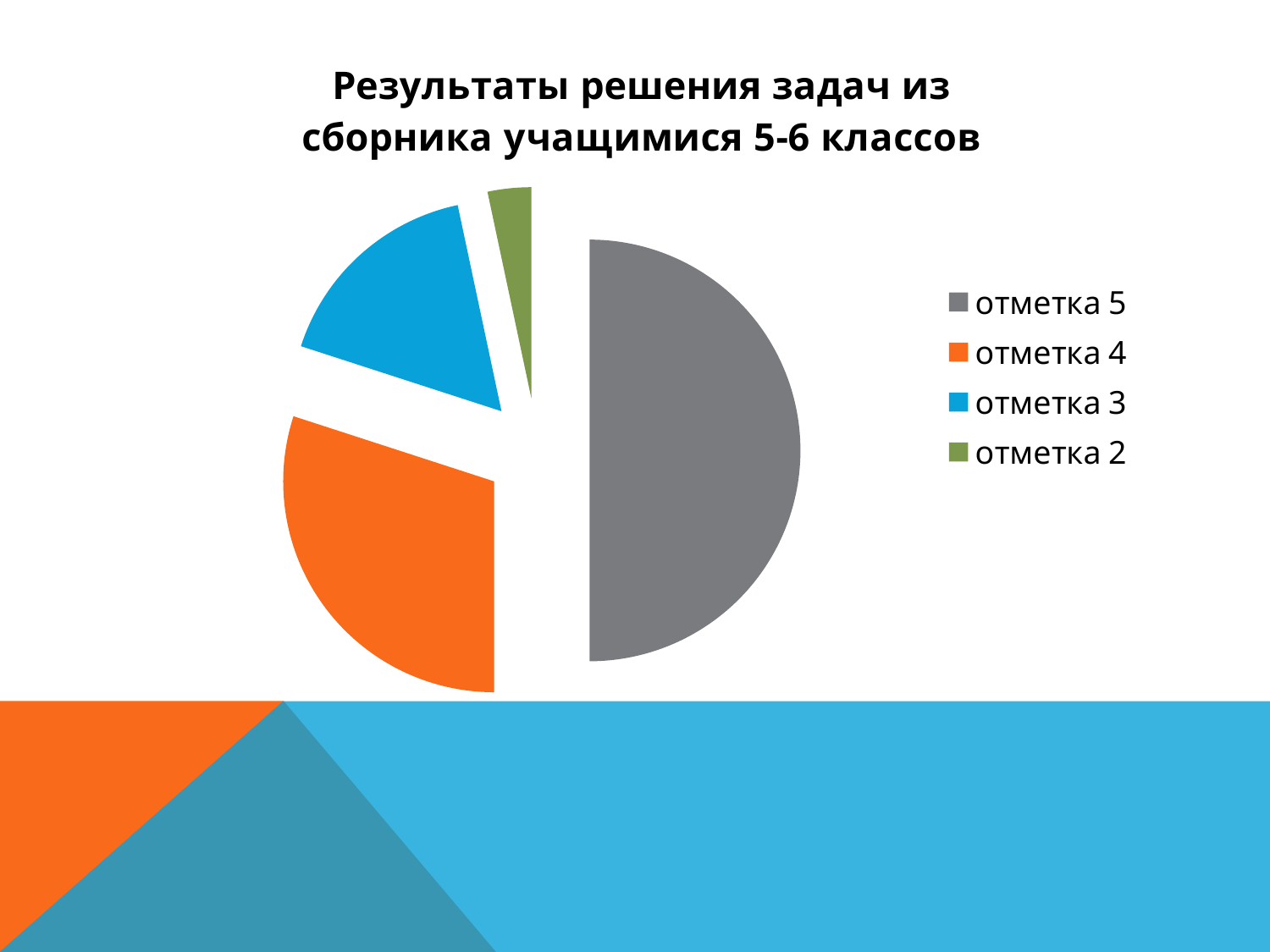
Which slice is larger, отметка 4 or отметка 3? отметка 4 What kind of chart is shown on the slide? pie chart Which slice is larger, отметка 5 or отметка 4? отметка 5 Which category has the largest slice of the pie? отметка 5 Which category has the smallest slice of the pie? отметка 2 What is the title of the chart? Результаты решения задач из сборника учащимися 5-6 классов How many entries does the legend list? 4 What colour is the slice for отметка 2? green How many slices does the pie chart have? 4 Which slice is larger, отметка 3 or отметка 2? отметка 3